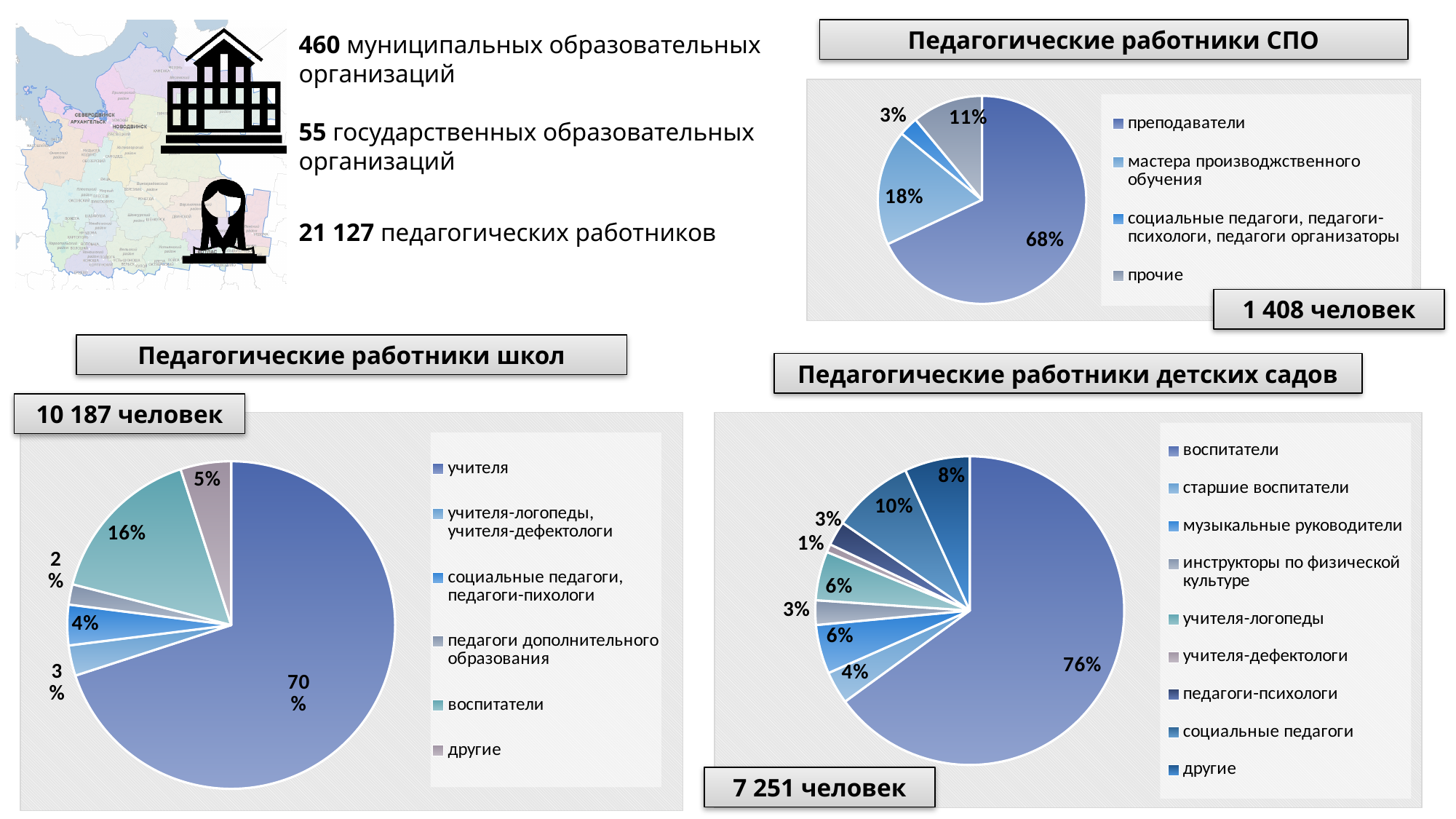
In the 'Педагогические работники детских садов' pie chart, what share is labelled for воспитатели? 76% In the 'Педагогические работники школ' pie chart, which is larger: социальные педагоги, педагоги-психологи or педагоги дополнительного образования? социальные педагоги, педагоги-психологи In the 'Педагогические работники школ' pie chart, what share is labelled for учителя? 70% In the 'Педагогические работники СПО' pie chart, what share is shown for мастера производственного обучения? 18% How many categories does the legend of the 'Педагогические работники детских садов' pie chart list? 9 How many legend entries does the 'Педагогические работники СПО' pie chart list? 4 In the 'Педагогические работники СПО' pie chart, which category has the smallest share? социальные педагоги, педагоги-психологи, педагоги организаторы In the 'Педагогические работники СПО' pie chart, what share is labelled for преподаватели? 68% In the 'Педагогические работники школ' pie chart, what share is shown for воспитатели? 16% What type of chart is used for 'Педагогические работники детских садов'? pie chart In the 'Педагогические работники школ' pie chart, what is the difference between the shares of воспитатели and другие? 11% In the 'Педагогические работники детских садов' pie chart, what share is shown for социальные педагоги? 10%